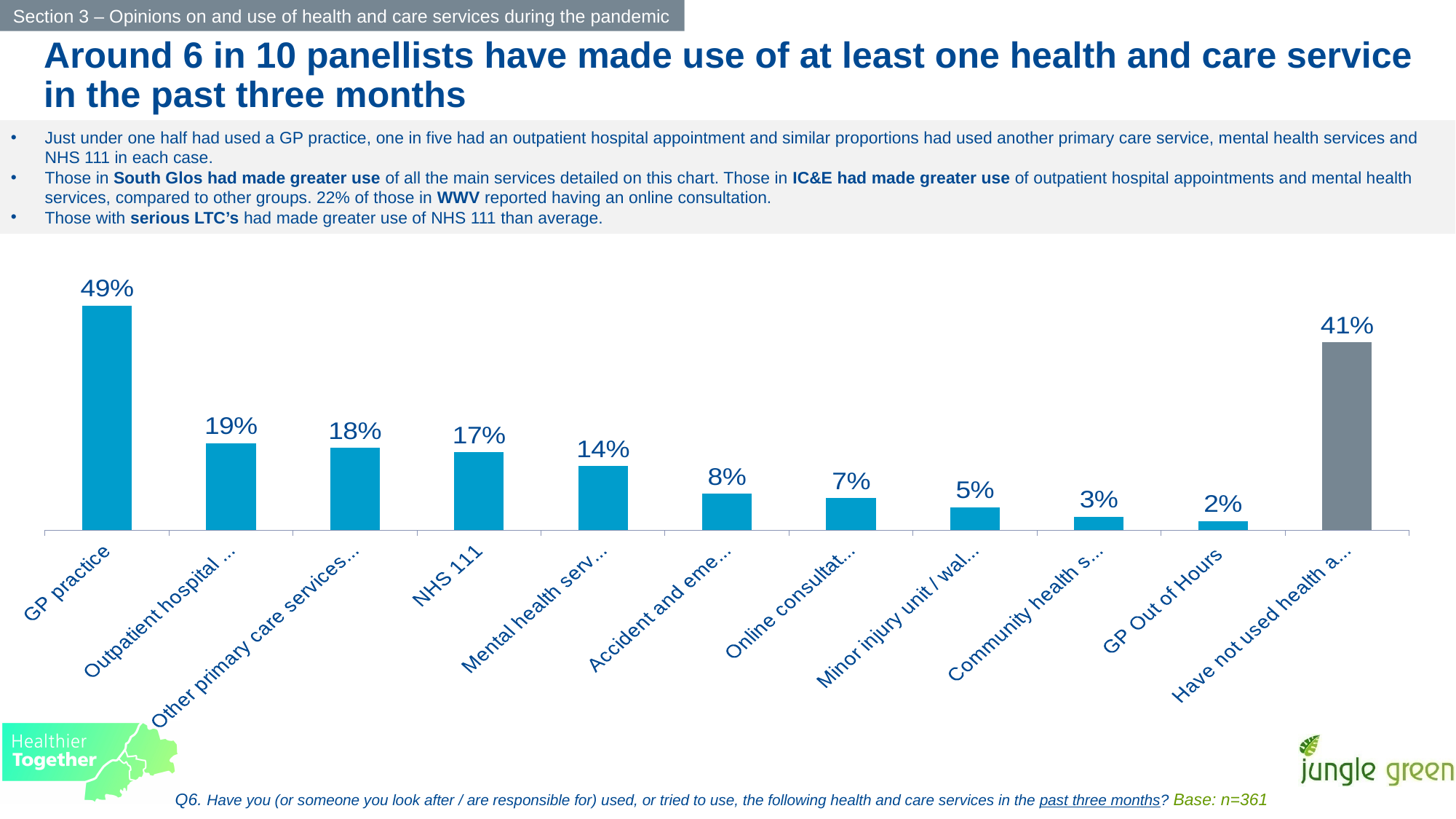
What is the difference between the GP practice value and the NHS 111 value? 32 percentage points Which category has the highest value in the chart? GP practice What type of chart is shown on the slide? Bar chart Which is larger, the value for GP practice or the value for the grey 'Have not used' bar? GP practice What colour is the bar for 'Have not used health a...' compared to the other bars? Grey (the others are blue) What is the value shown for the grey bar on the far right (Have not used health a...)? 41% Do the values of the blue bars rise or fall from left to right? Fall What is the value shown for GP Out of Hours? 2% How many bars are plotted in the chart? 11 Which category has the lowest value in the chart? GP Out of Hours What is the value shown for NHS 111? 17% What percentage of panellists had used a GP practice? 49%